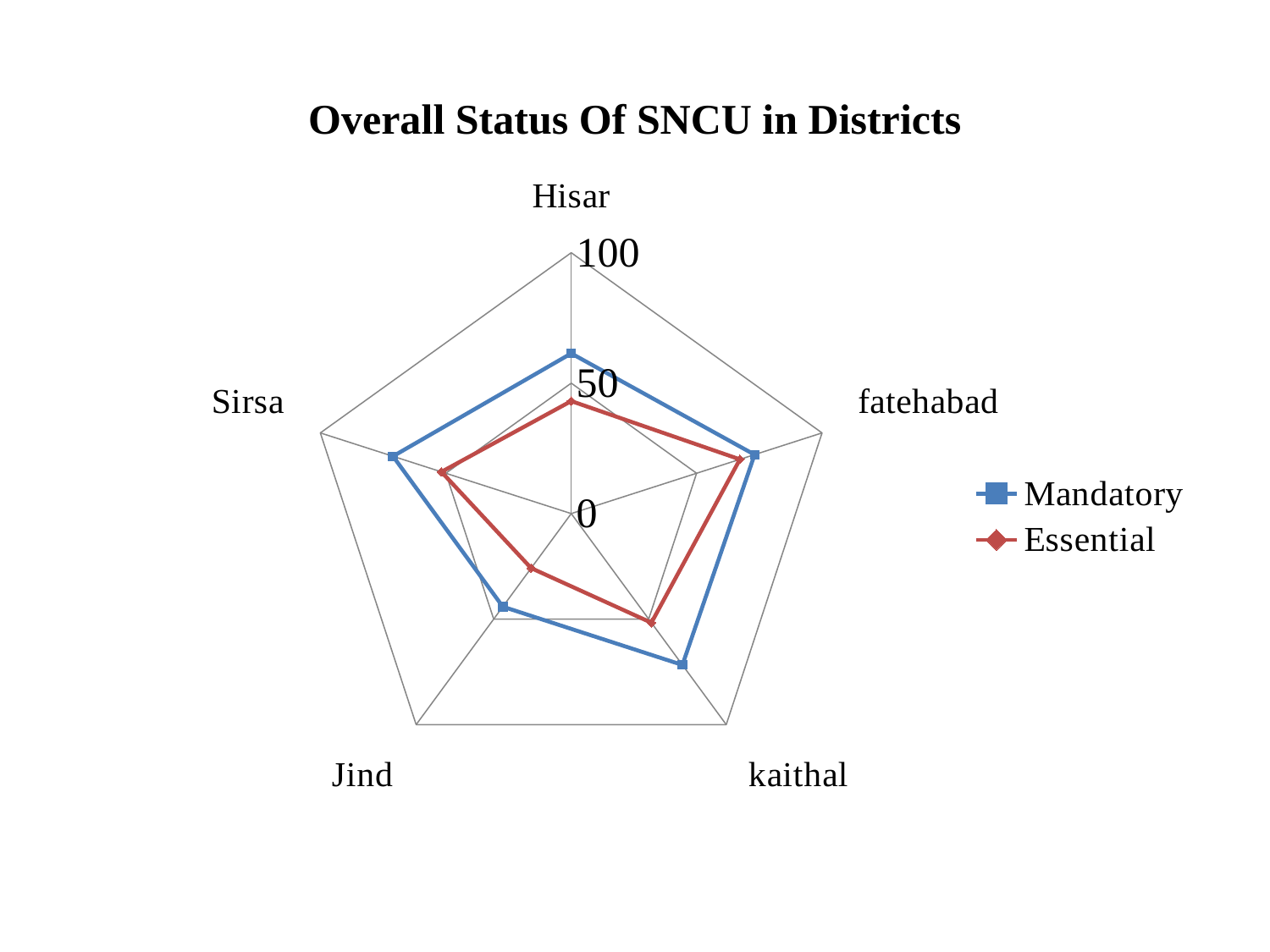
How many series does the legend list? 2 Is the Essential value for fatehabad greater or less than 50? greater Is the Mandatory value for kaithal greater or less than 50? greater What is the title of the chart? Overall Status Of SNCU in Districts How many districts (categories) are plotted on the chart? 5 Is the Essential value for Jind greater or less than 50? less Which series is drawn in blue? Mandatory What kind of chart is shown on the slide? Radar chart For Jind, which series has the larger value, Mandatory or Essential? Mandatory Which district has the lowest Essential value? Jind